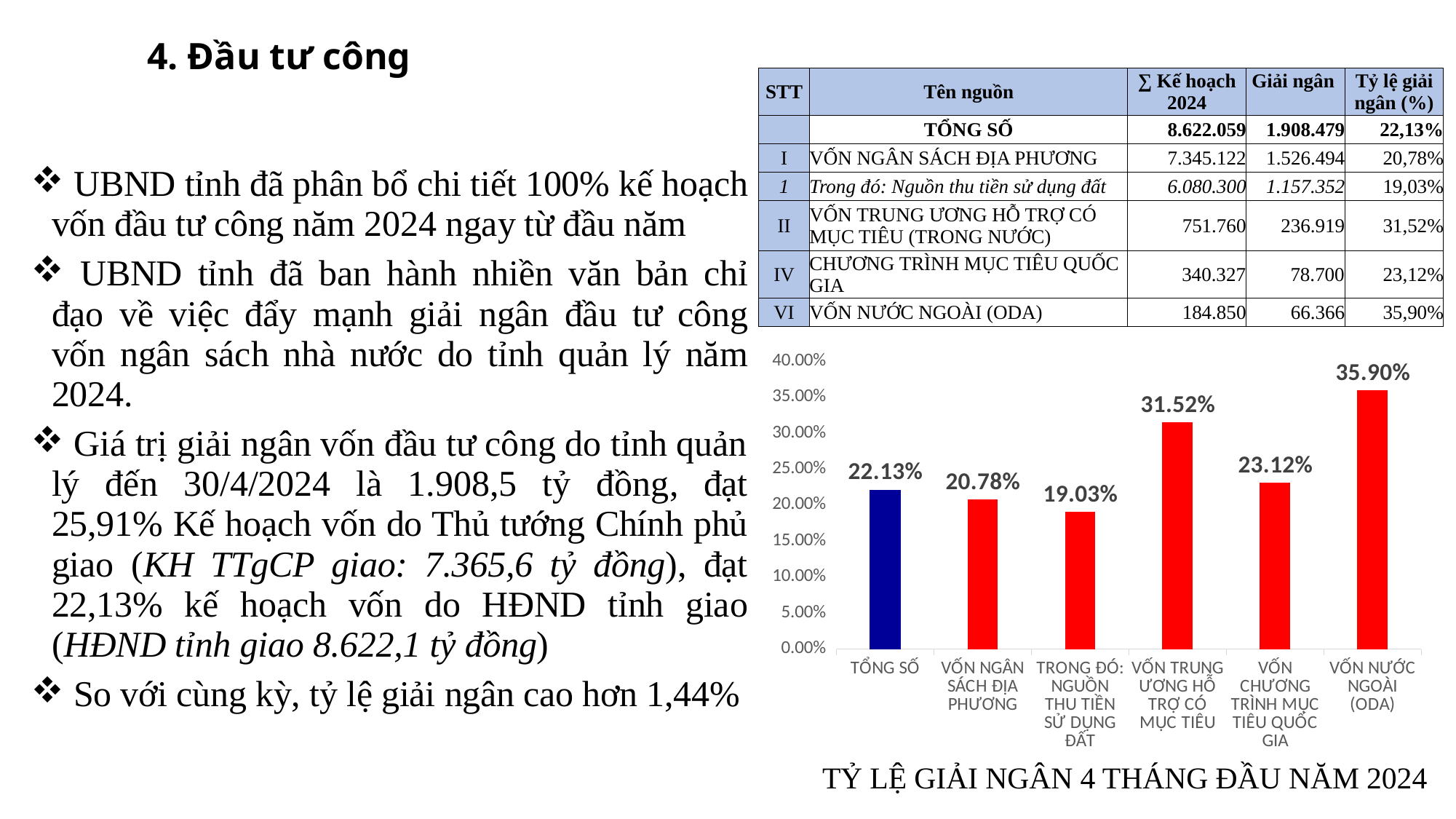
What is the value for VỐN TRUNG ƯƠNG HỖ TRỢ CÓ MỤC TIÊU in the chart? 31.52% Is the value for VỐN TRUNG ƯƠNG HỖ TRỢ CÓ MỤC TIÊU greater or less than 30.00%? greater What is the title of the chart? TỶ LỆ GIẢI NGÂN 4 THÁNG ĐẦU NĂM 2024 How many categories are shown in the chart? 6 What type of chart is shown on the slide? bar chart Which category has the highest value in the chart? VỐN NƯỚC NGOÀI (ODA) What is the difference between the values for VỐN NƯỚC NGOÀI (ODA) and TỔNG SỐ? 13.77% What is the value for TỔNG SỐ in the chart? 22.13% What is the value for VỐN NƯỚC NGOÀI (ODA) in the chart? 35.90% Which category has the lowest value in the chart? TRONG ĐÓ: NGUỒN THU TIỀN SỬ DỤNG ĐẤT Which is larger: the value for VỐN CHƯƠNG TRÌNH MỤC TIÊU QUỐC GIA or the value for VỐN NGÂN SÁCH ĐỊA PHƯƠNG? VỐN CHƯƠNG TRÌNH MỤC TIÊU QUỐC GIA What colour is the bar for TỔNG SỐ in the chart? blue